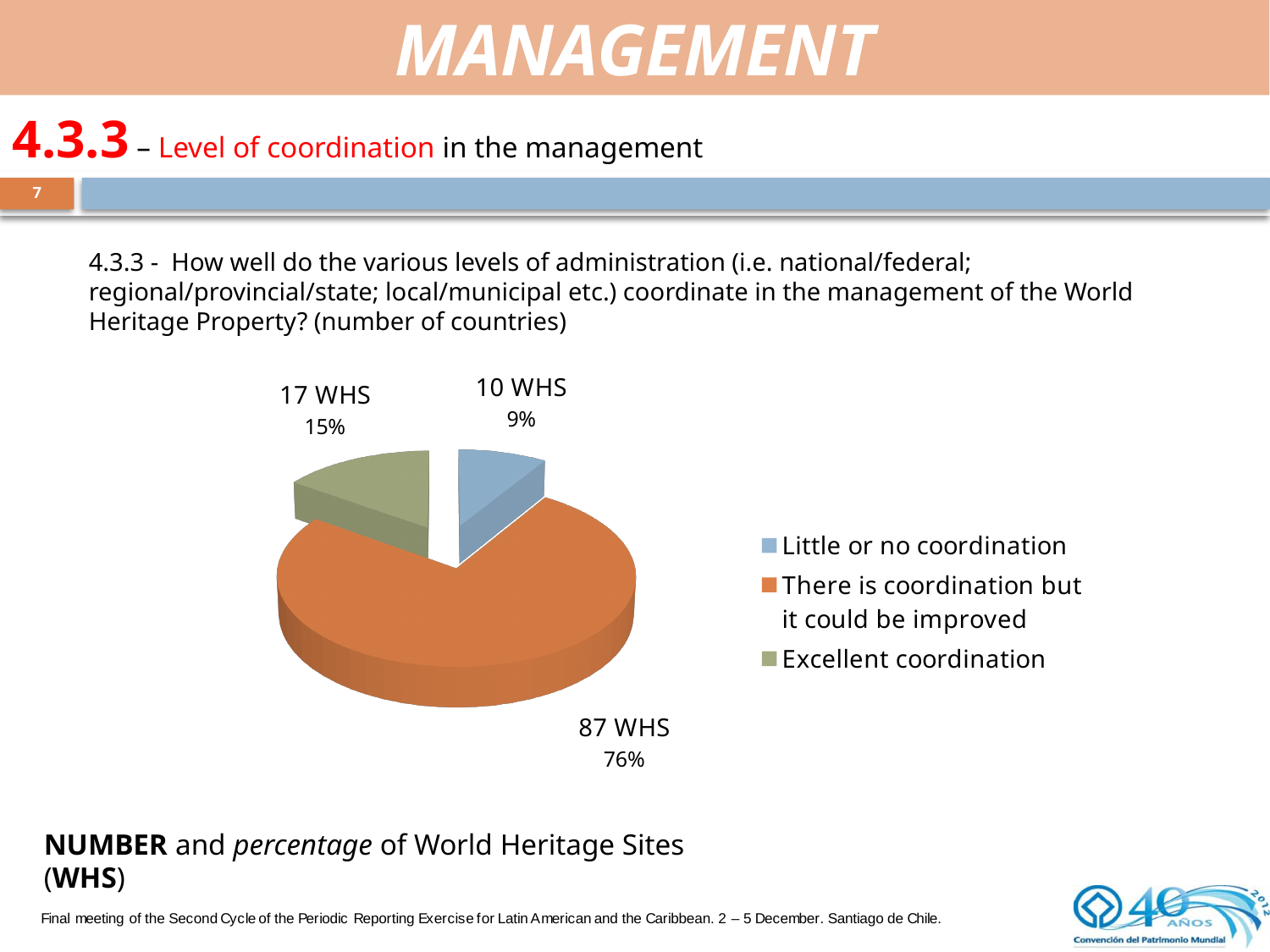
How many World Heritage Sites reported 'Excellent coordination'? 17 WHS How many more World Heritage Sites reported 'Excellent coordination' than 'Little or no coordination'? 7 How many World Heritage Sites reported 'There is coordination but it could be improved'? 87 WHS How many categories does the pie chart have? 3 Which category has the smallest slice of the pie? Little or no coordination What share of the pie does 'Excellent coordination' represent? 15% What percentage of World Heritage Sites reported 'Little or no coordination'? 9% Which category has the largest slice of the pie? There is coordination but it could be improved What colour is the slice for 'There is coordination but it could be improved'? orange What is the total number of World Heritage Sites across all three slices? 114 What kind of chart is shown on the slide? pie chart Which is larger: the number of sites with 'Excellent coordination' or with 'Little or no coordination'? Excellent coordination